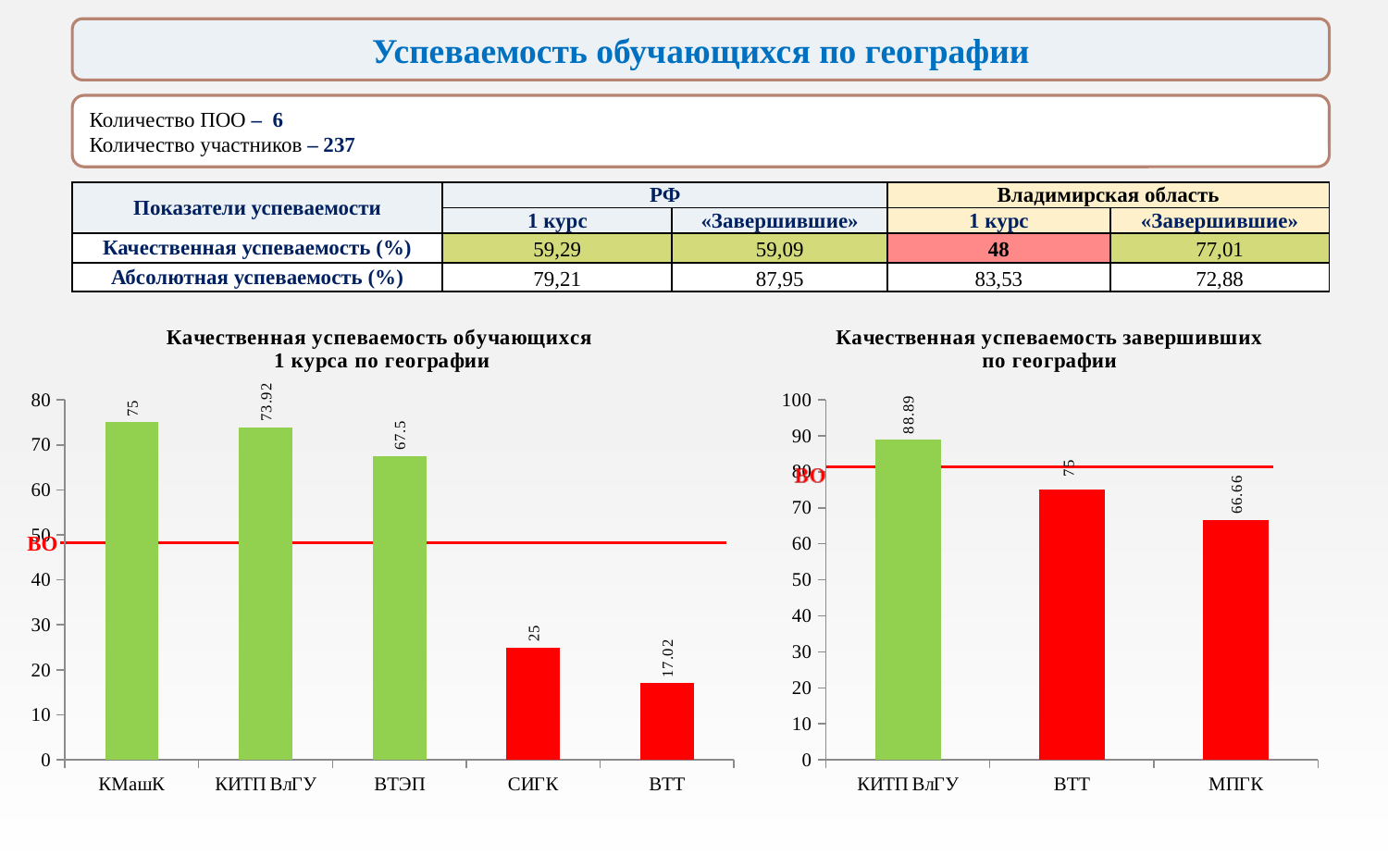
In the left chart (Качественная успеваемость обучающихся 1 курса по географии), what is the value for ВТЭП? 67.5 In the right chart (Качественная успеваемость завершивших по географии), what is the value for МПГК? 66.66 In the left chart (Качественная успеваемость обучающихся 1 курса по географии), which category has the highest value? КМашК What type of chart is the right chart (Качественная успеваемость завершивших по географии)? bar chart In the left chart (Качественная успеваемость обучающихся 1 курса по географии), which category has the lowest value? ВТТ In the left chart (Качественная успеваемость обучающихся 1 курса по географии), what is the value for ВТТ? 17.02 In the right chart (Качественная успеваемость завершивших по географии), which category has the lowest value? МПГК In the right chart (Качественная успеваемость завершивших по географии), what is the value for КИТП ВлГУ? 88.89 In the left chart (Качественная успеваемость обучающихся 1 курса по географии), what is the difference between the values for КМашК and СИГК? 50 In the right chart (Качественная успеваемость завершивших по географии), which is larger, the value for ВТТ or the value for МПГК? ВТТ In the left chart (Качественная успеваемость обучающихся 1 курса по географии), how many categories are shown on the x axis? 5 In the left chart (Качественная успеваемость обучающихся 1 курса по географии), is the value for СИГК greater or less than 30? less